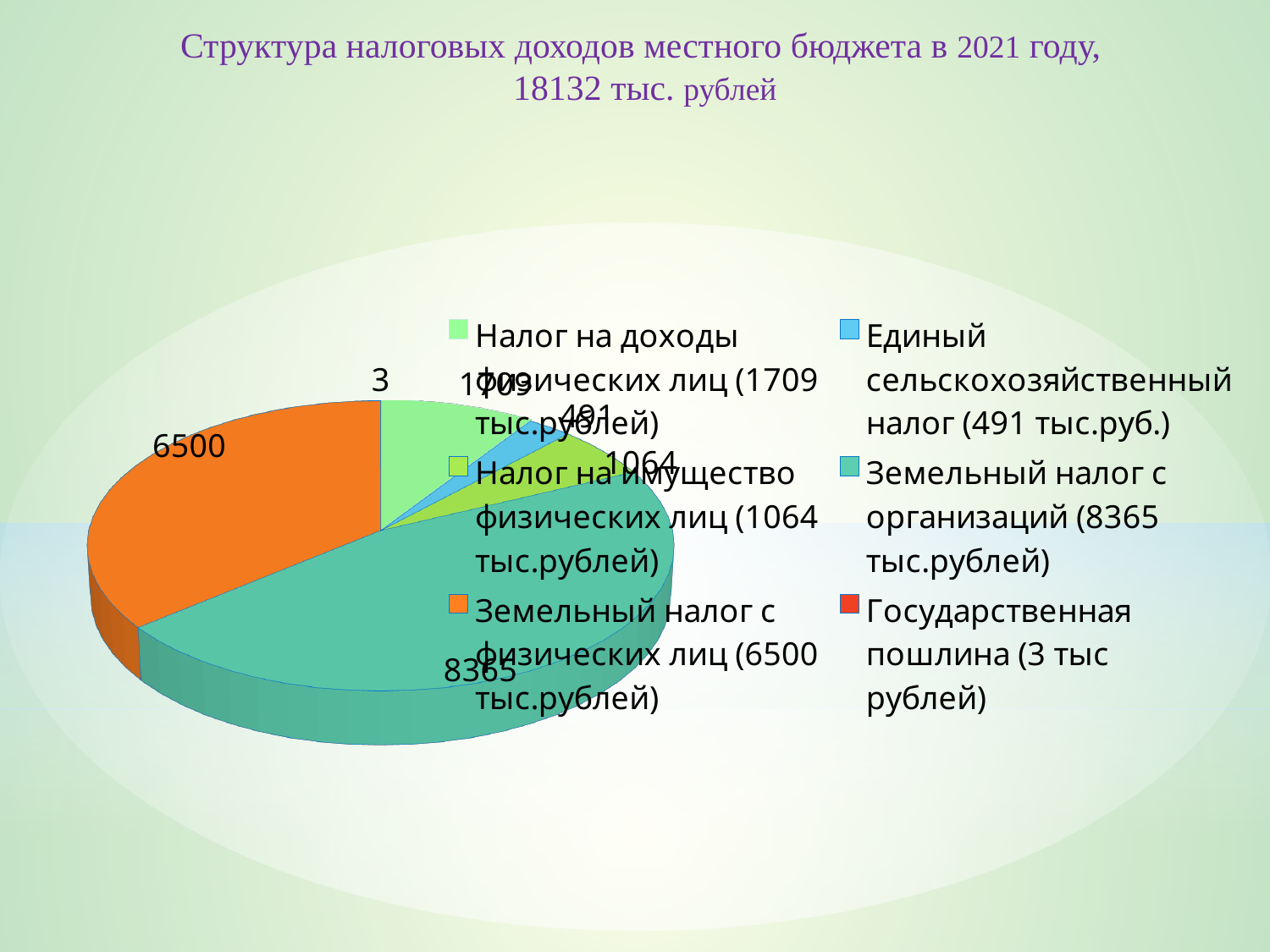
What is the value for Налог на доходы физических лиц? 1709 Which is larger: Налог на доходы физических лиц or Налог на имущество физических лиц? Налог на доходы физических лиц What total amount in тыс. рублей is stated in the chart title? 18132 тыс. рублей What is the value for Единый сельскохозяйственный налог? 491 What is the value for Земельный налог с физических лиц? 6500 Which category has the largest slice of the pie? Земельный налог с организаций How many categories does the legend list? 6 What is the difference between the values for Земельный налог с организаций and Земельный налог с физических лиц? 1865 Which category has the smallest slice of the pie? Государственная пошлина What type of chart is shown on the slide? Pie chart What is the value for Государственная пошлина? 3 What is the value for Земельный налог с организаций? 8365